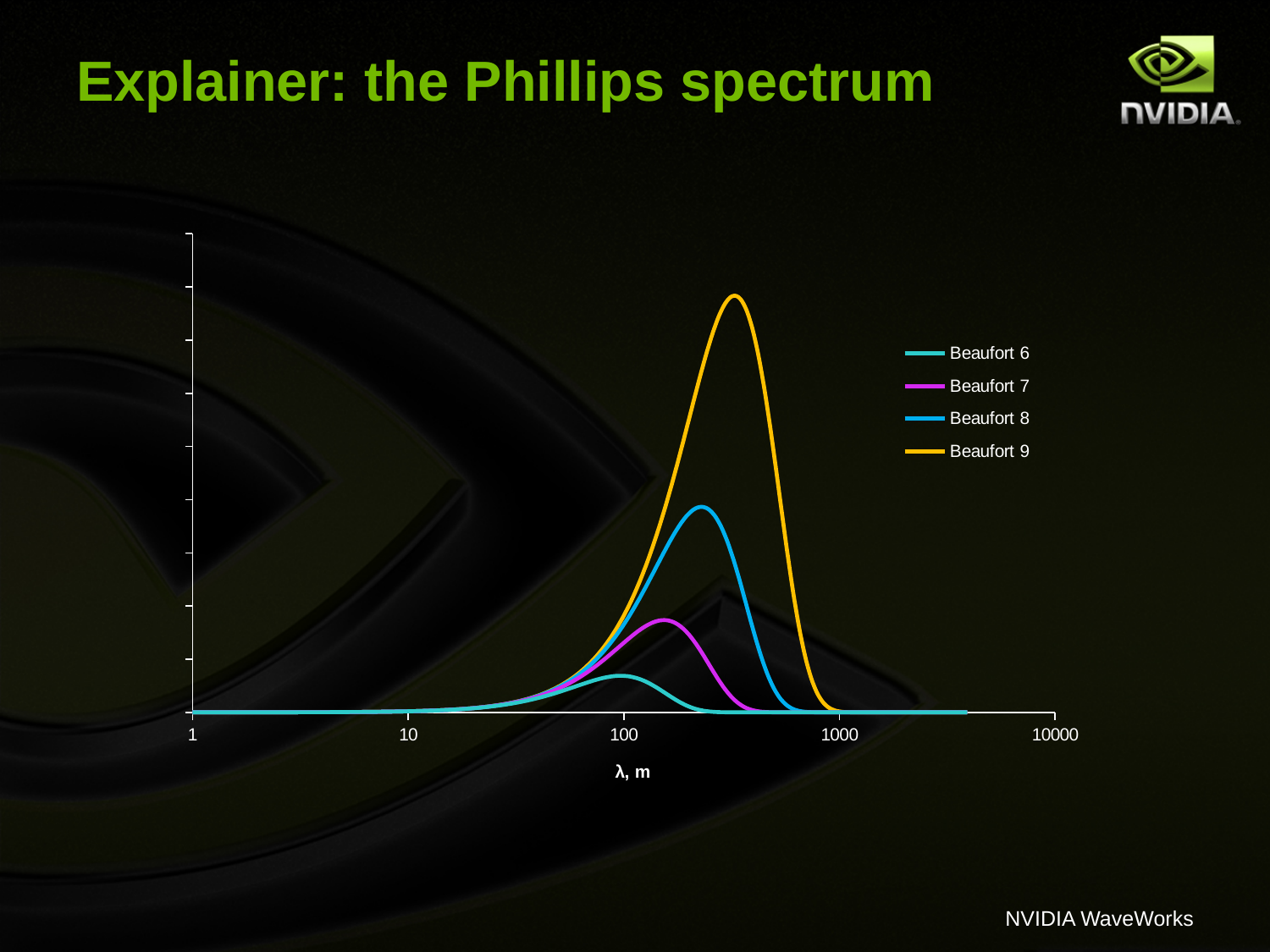
Is the wavelength at which the Beaufort 9 curve peaks greater or less than 100? greater Which series has a higher peak, Beaufort 7 or Beaufort 8? Beaufort 8 What kind of chart is shown on the slide? line chart What colour is the Beaufort 9 line? yellow/orange How many series does the legend list? 4 Which series peaks at the longest wavelength? Beaufort 9 Which series has a higher peak, Beaufort 6 or Beaufort 7? Beaufort 7 Is the wavelength at which the Beaufort 8 curve peaks greater or less than 1000? less What is the largest tick value shown on the x axis? 10000 What is the label of the x axis? λ, m Which series reaches the highest peak value? Beaufort 9 Which series has the lowest peak value? Beaufort 6